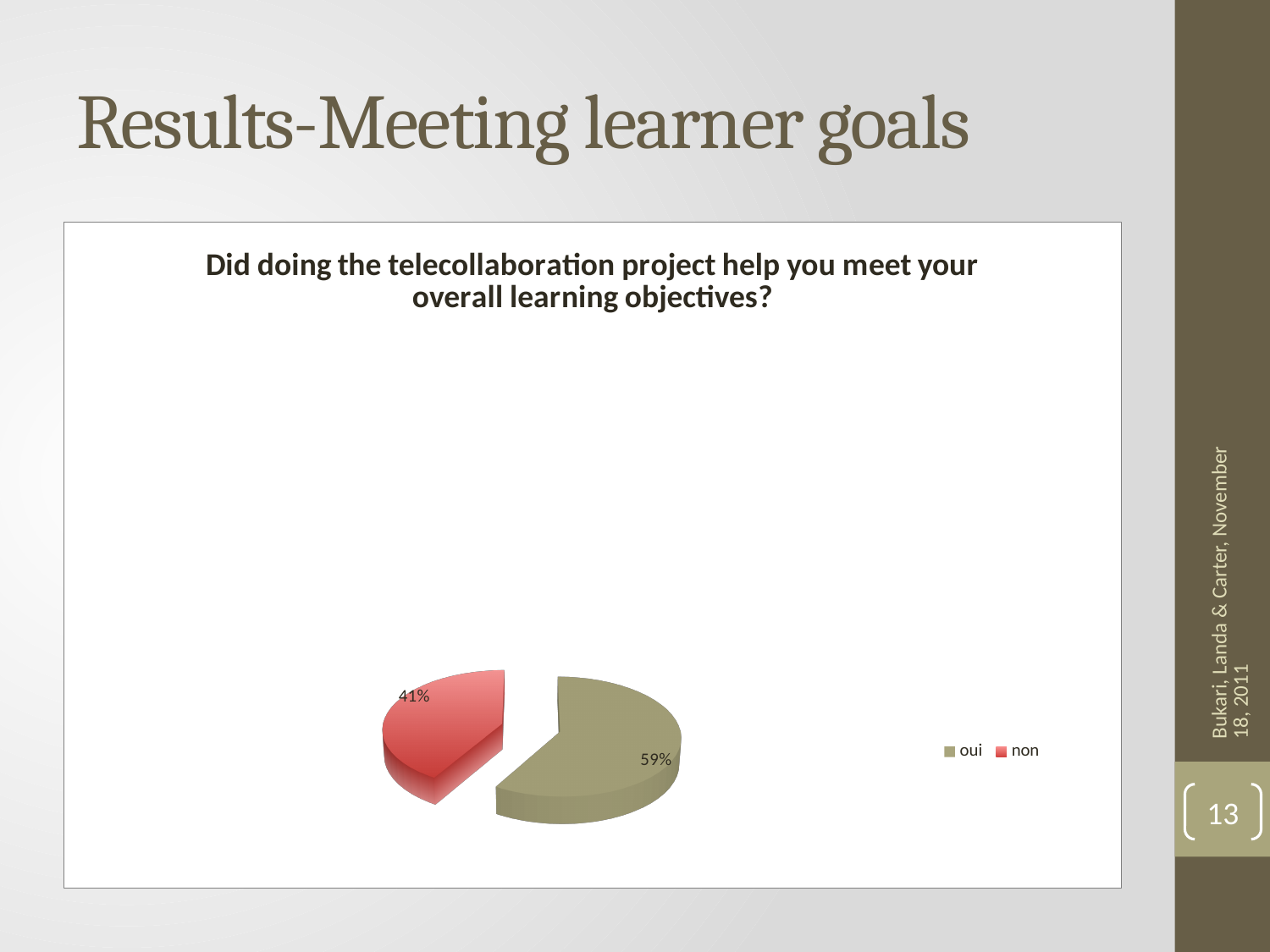
What colour is the "non" slice? red What is the title of the chart? Did doing the telecollaboration project help you meet your overall learning objectives? How many slices does the pie chart have? 2 What percentage of respondents answered "oui"? 59% How many entries does the legend list? 2 What is the difference in percentage points between the "oui" and "non" slices? 18 Which response has the largest share of the pie? oui What percentage of respondents answered "non"? 41% Which response has the smallest share of the pie? non What kind of chart is shown on the slide? pie chart Which slice is larger, "oui" or "non"? oui Is the share for "oui" greater or less than 50%? greater